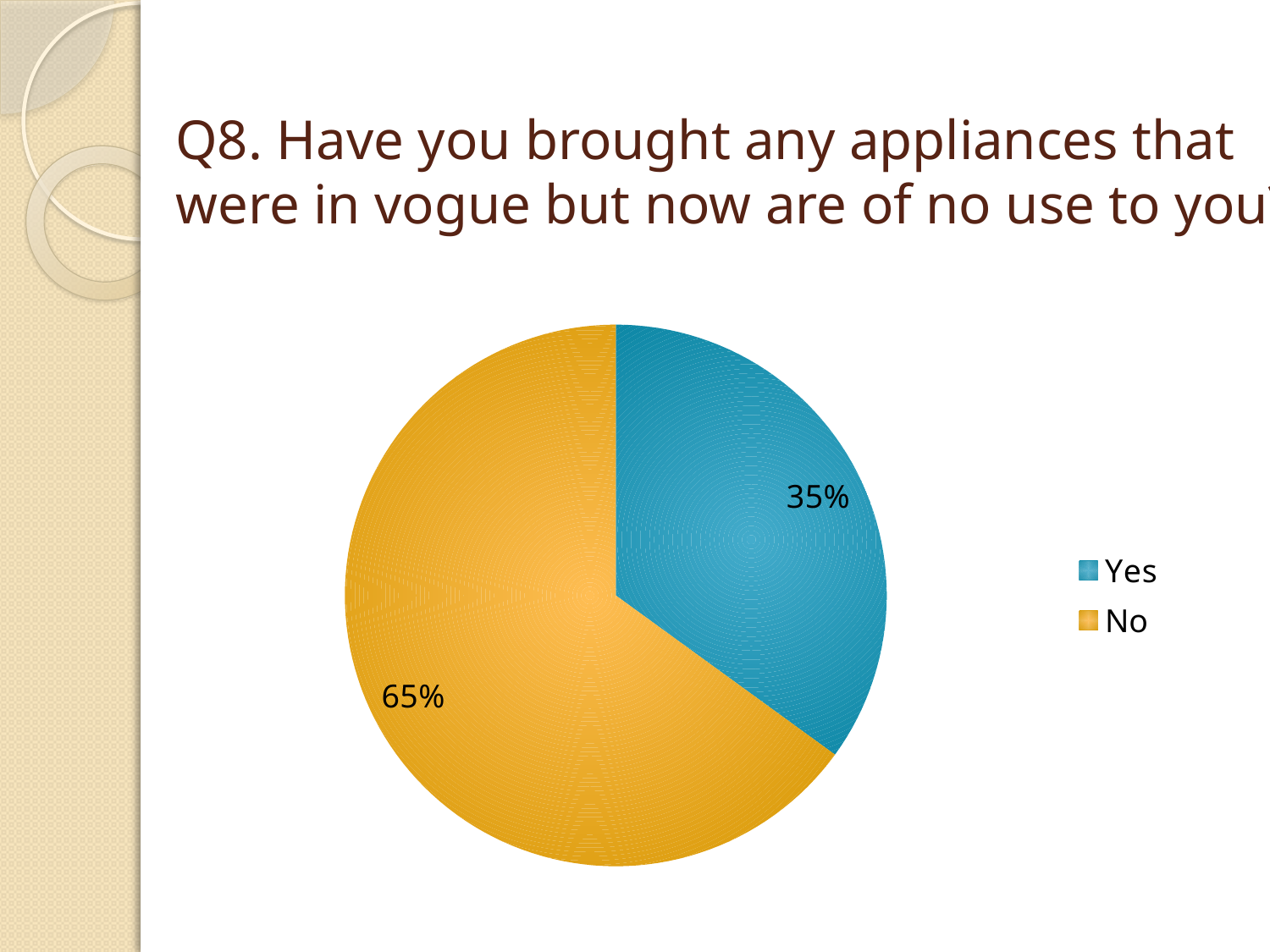
What percentage of respondents answered No? 65% What share of the pie does the Yes slice represent? 35% What kind of chart is shown on the slide? pie chart What colour is the Yes slice? blue Which response has the smallest share of the pie? Yes Which response has the largest share of the pie? No What percentage of respondents answered Yes? 35% How many slices does the pie chart have? 2 How many entries does the legend list? 2 What is the difference in percentage points between the No and Yes slices? 30 Which slice is larger, Yes or No? No What colour is the No slice? orange